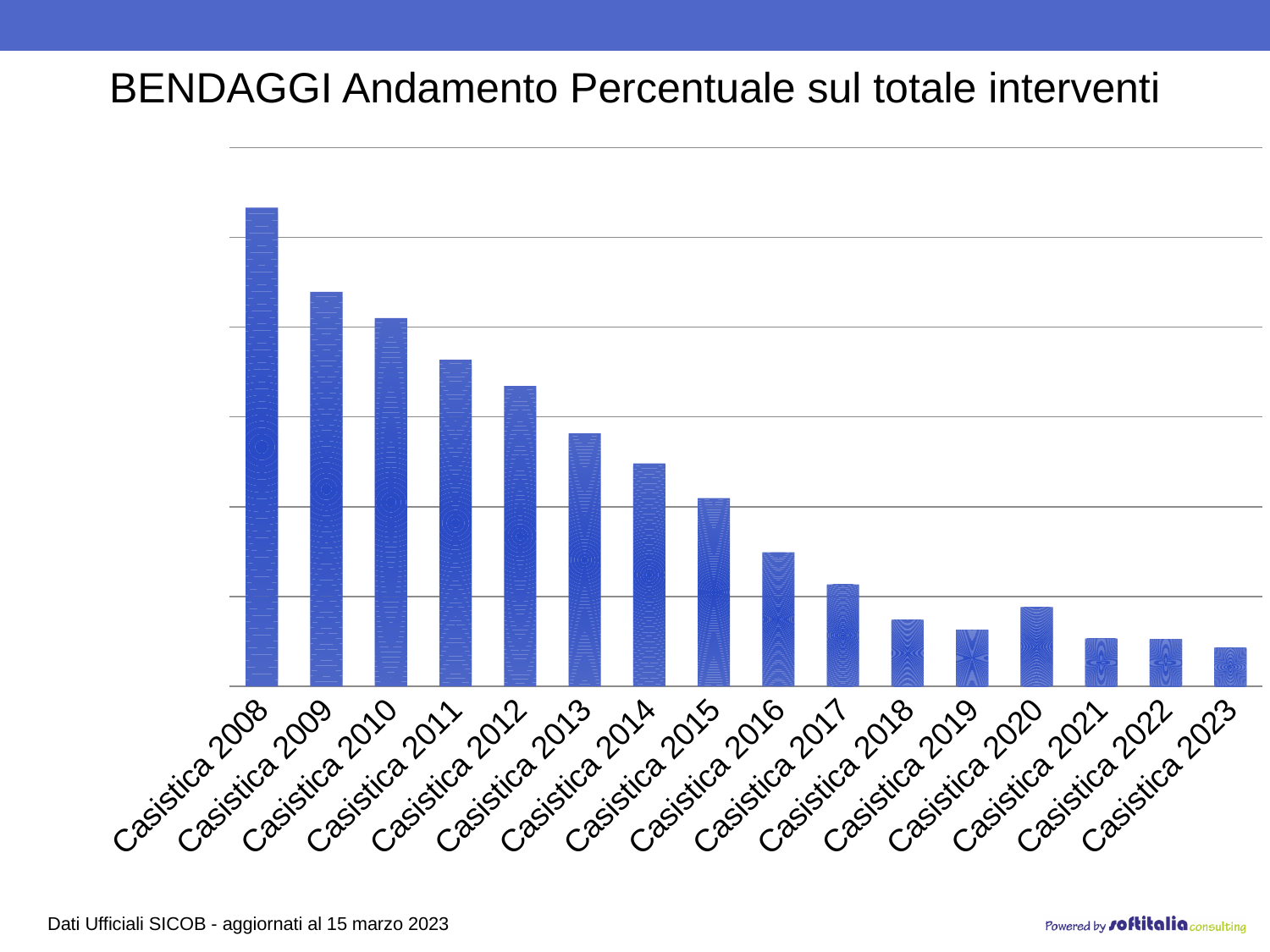
What is the title of the chart? BENDAGGI Andamento Percentuale sul totale interventi Which is larger, the value for Casistica 2019 or Casistica 2020? Casistica 2020 What kind of chart is shown on the slide? Bar chart Do the values generally rise or fall from Casistica 2008 to Casistica 2023? Fall Which is larger, the value for Casistica 2008 or Casistica 2009? Casistica 2008 Which category has the highest bar in the chart? Casistica 2008 How many categories (bars) are plotted in the chart? 16 What is the first category on the x axis? Casistica 2008 Which is larger, the value for Casistica 2013 or Casistica 2015? Casistica 2013